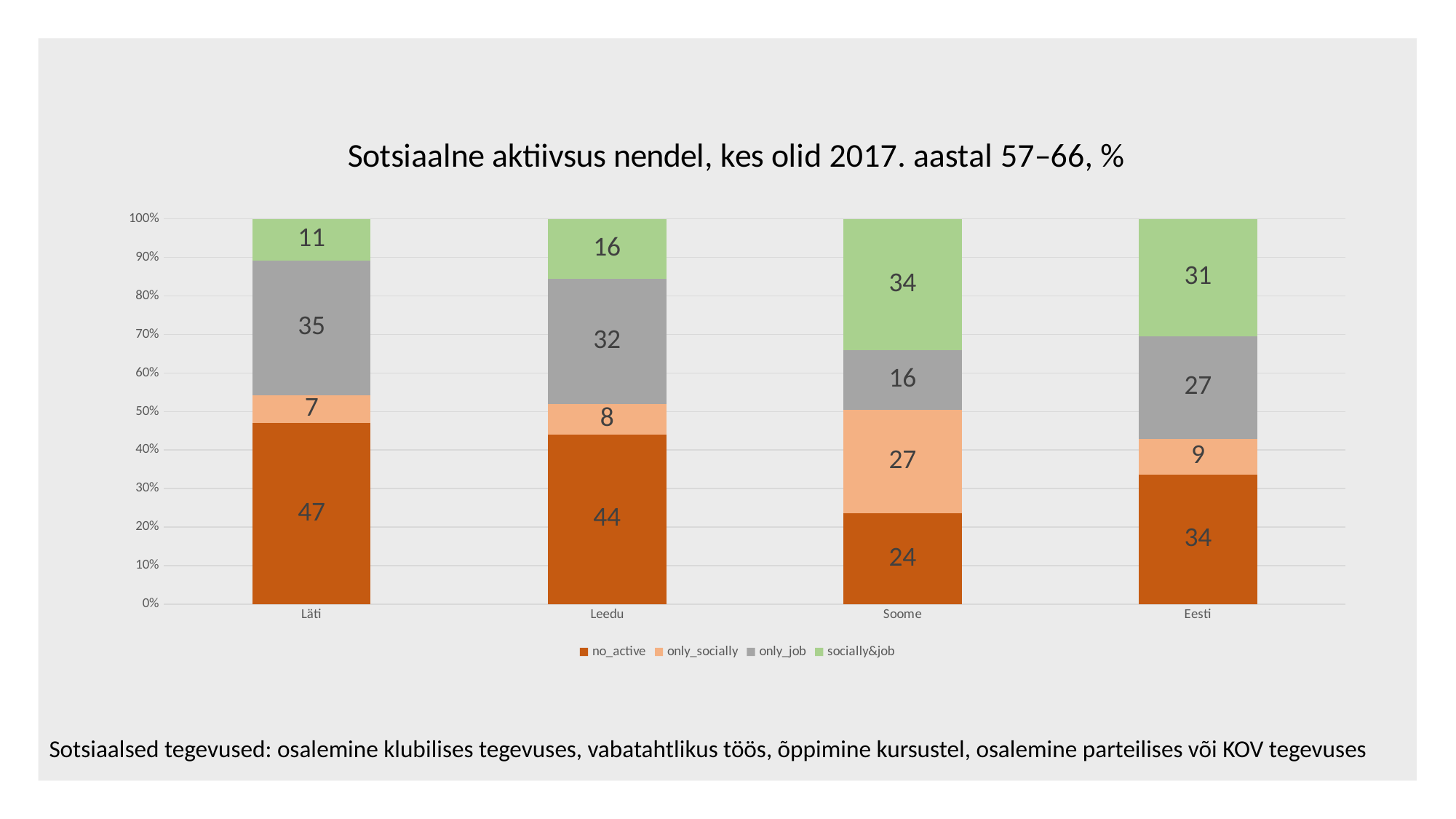
How many countries are shown on the x axis? 4 What is the only_socially value for Leedu? 8 What is the no_active value for Läti? 47 Which is larger, the only_job value for Läti or for Soome? Läti Which country has the highest no_active value? Läti What kind of chart is shown on the slide? Stacked bar chart What is the socially&job value for Soome? 34 What is the title of the chart? Sotsiaalne aktiivsus nendel, kes olid 2017. aastal 57–66, % What is the only_job value for Eesti? 27 Which country has the lowest socially&job value? Läti How many series does the legend list? 4 What is the difference between the only_socially values for Soome and Läti? 20